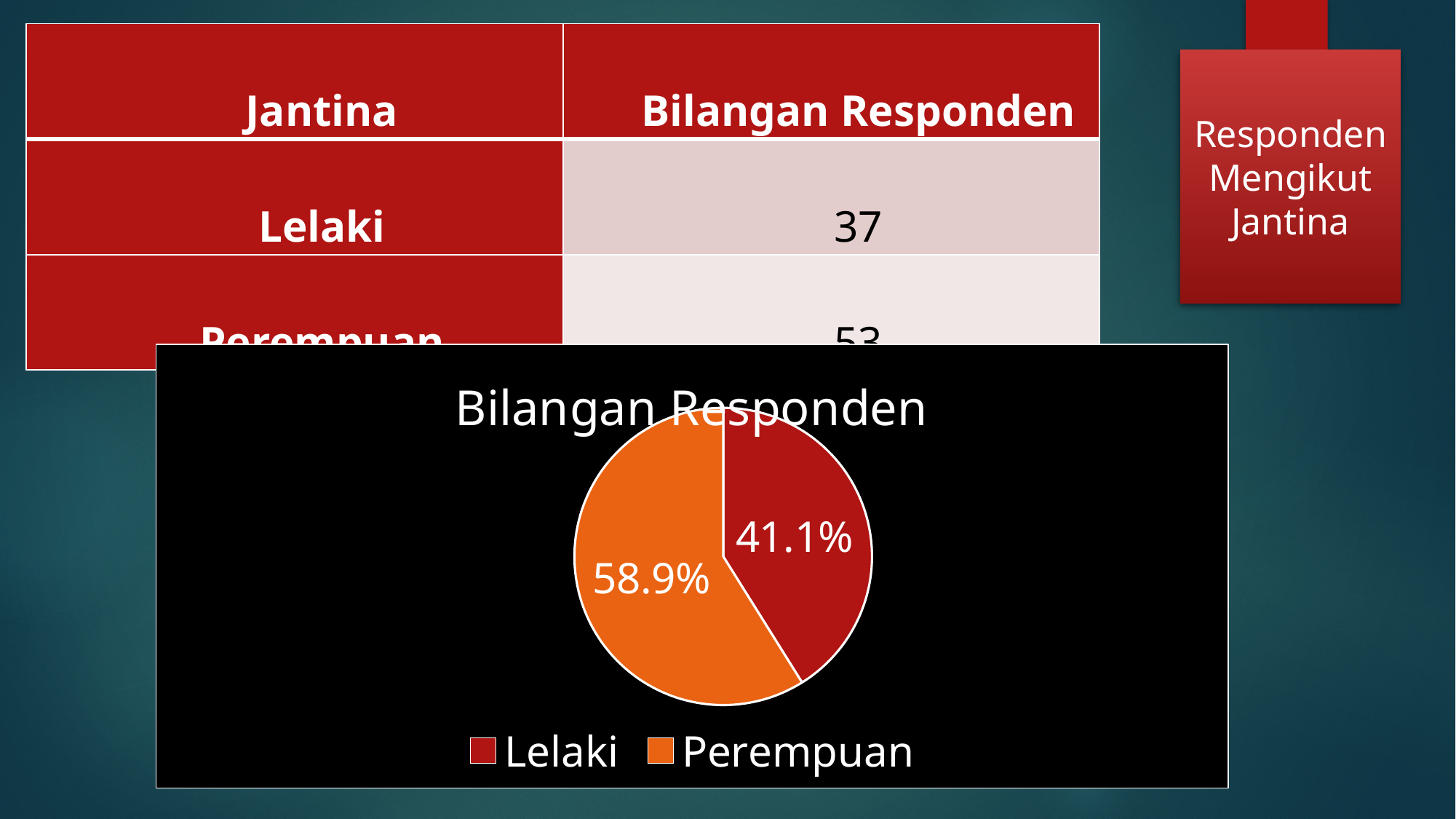
How many slices does the pie chart have? 2 What is the title of the chart? Bilangan Responden Which category has the largest slice of the pie? Perempuan What is the difference in percentage points between the Perempuan and Lelaki slices? 17.8 Which category has the smallest slice of the pie? Lelaki What type of chart is shown on the slide? pie chart Is the Lelaki share of the pie greater or less than 50%? less How many entries does the chart legend list? 2 What percentage of the pie does Perempuan represent? 58.9% Which slice is larger, Lelaki or Perempuan? Perempuan What percentage of the pie does Lelaki represent? 41.1% What colour is the Perempuan slice in the pie chart? orange